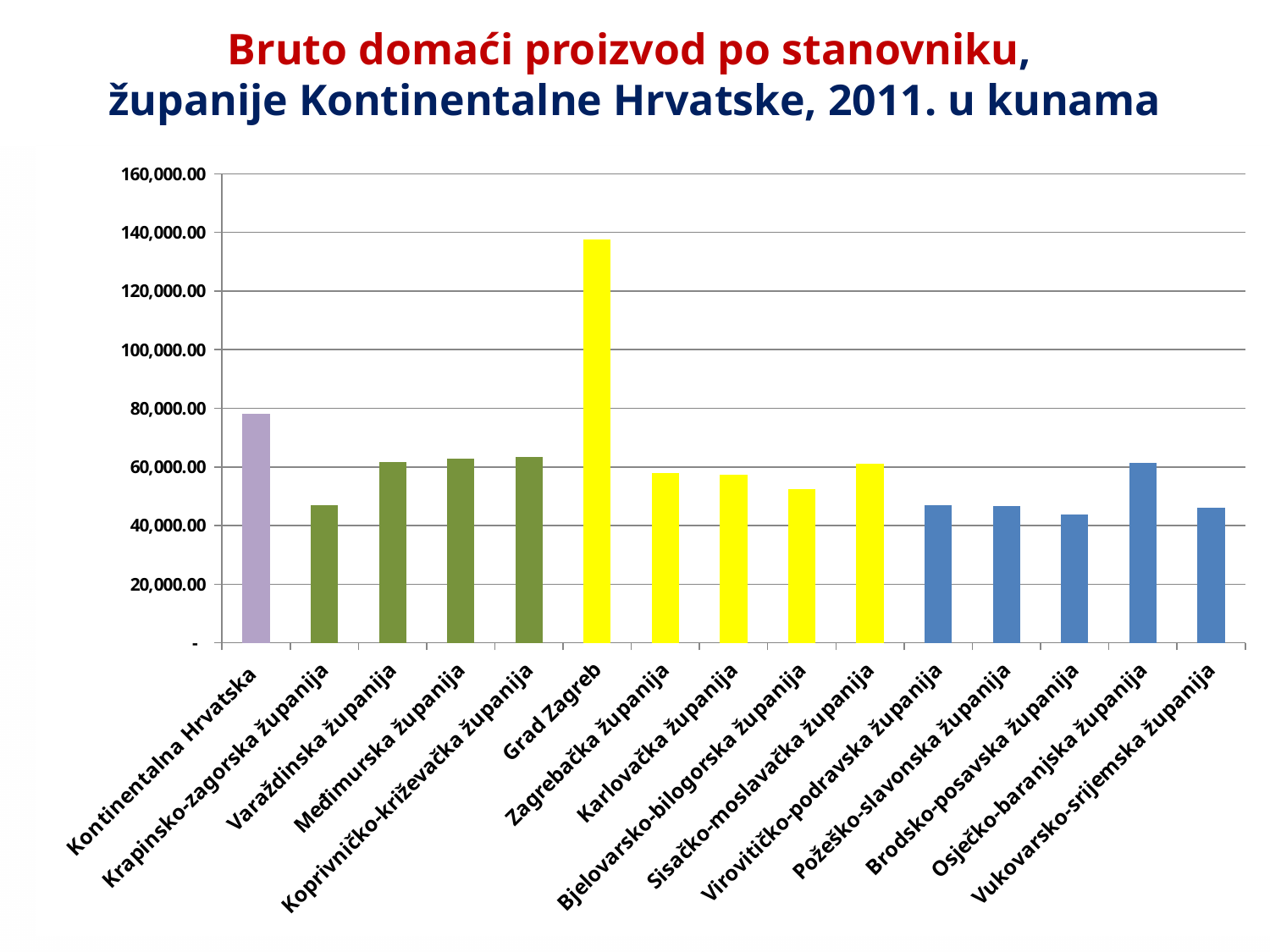
Is the value for Kontinentalna Hrvatska greater or less than 60,000.00? greater What colour is the bar for Grad Zagreb? Yellow Is the value for Grad Zagreb greater or less than 120,000.00? greater Is the value for Brodsko-posavska županija greater or less than 60,000.00? less Which category has the highest value in the chart? Grad Zagreb Which is larger, the value for Kontinentalna Hrvatska or the value for Varaždinska županija? Kontinentalna Hrvatska How many categories are plotted on the x axis of the chart? 15 Which is larger, the value for Koprivničko-križevačka županija or the value for Bjelovarsko-bilogorska županija? Koprivničko-križevačka županija Which is larger, the value for Grad Zagreb or the value for Kontinentalna Hrvatska? Grad Zagreb What kind of chart is shown on the slide? Bar chart